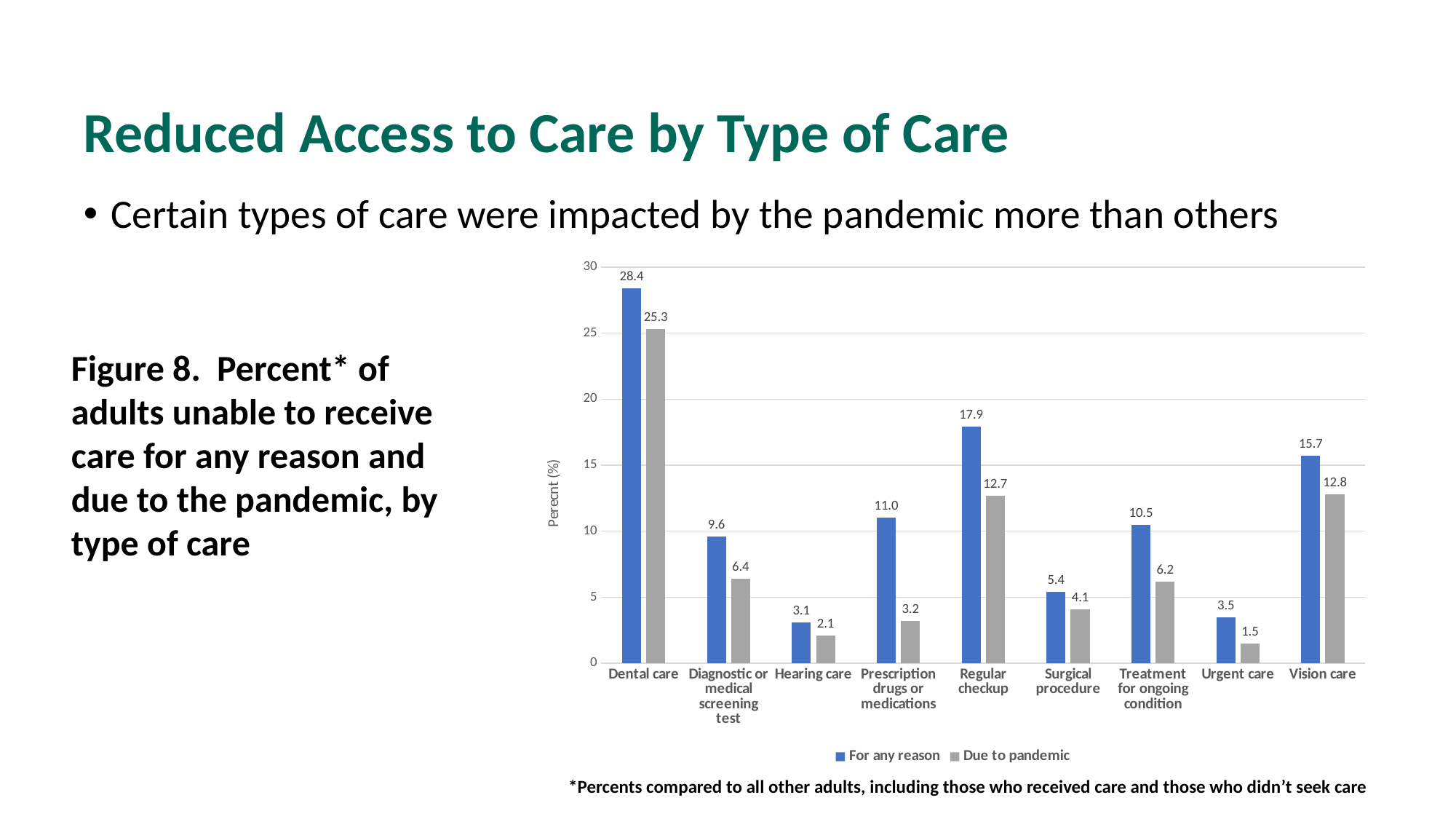
What is the value for Vision care in the 'Due to pandemic' series? 12.8 What kind of chart is shown on the slide? Bar chart Which is larger: the 'For any reason' value for Prescription drugs or medications or the 'For any reason' value for Treatment for ongoing condition? Prescription drugs or medications Which type of care has the highest value in the 'For any reason' series? Dental care Is the 'Due to pandemic' value for Dental care greater or less than 20? greater What is the difference between the 'For any reason' and 'Due to pandemic' values for Regular checkup? 5.2 What is the value for Urgent care in the 'Due to pandemic' series? 1.5 What is the value for Dental care in the 'For any reason' series? 28.4 How many types of care are shown on the x axis? 9 How many series does the legend list? 2 What is the label of the y axis? Perecnt (%) Which type of care has the lowest value in the 'Due to pandemic' series? Urgent care